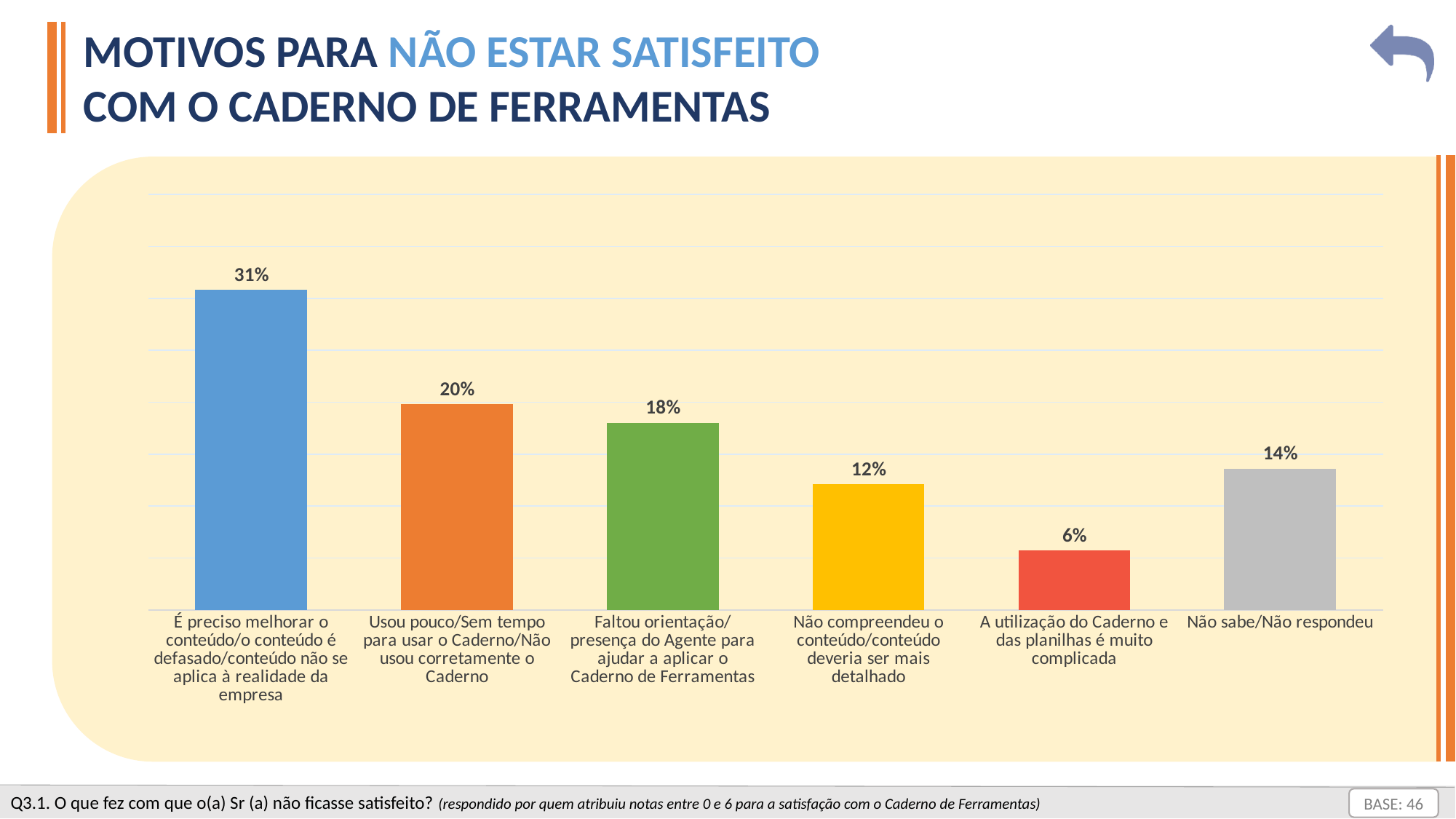
What percentage is shown for 'A utilização do Caderno e das planilhas é muito complicada'? 6% Which category has the lowest value? A utilização do Caderno e das planilhas é muito complicada What colour is the bar for 'Usou pouco/Sem tempo para usar o Caderno/Não usou corretamente o Caderno'? Orange Which is larger: the value for 'Não compreendeu o conteúdo/conteúdo deveria ser mais detalhado' or for 'Não sabe/Não respondeu'? Não sabe/Não respondeu What is the base (number of respondents) indicated on the slide? 46 What is the difference between the value for 'É preciso melhorar o conteúdo...' (31%) and 'Usou pouco/Sem tempo para usar o Caderno...' (20%)? 11% What is the difference between the values for 'Não compreendeu o conteúdo/conteúdo deveria ser mais detalhado' and 'A utilização do Caderno e das planilhas é muito complicada'? 6% What percentage is shown for 'Não sabe/Não respondeu'? 14% What is the value for 'Faltou orientação/presença do Agente para ajudar a aplicar o Caderno de Ferramentas'? 18% What kind of chart is shown on the slide? Bar chart How many categories are shown in the chart? 6 Which category has the highest value? É preciso melhorar o conteúdo/o conteúdo é defasado/conteúdo não se aplica à realidade da empresa